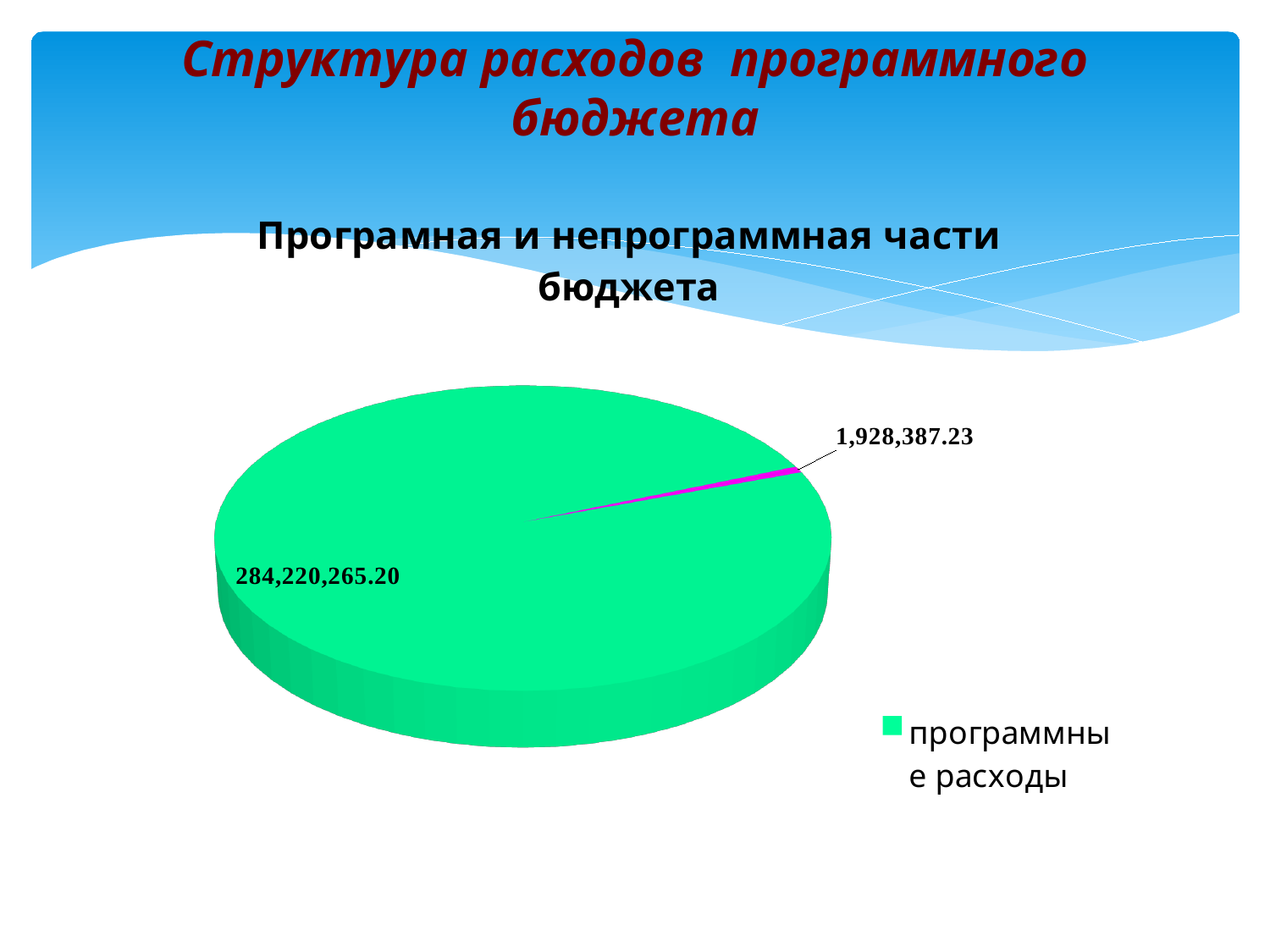
Which is larger: the green slice or the magenta slice? the green slice How many entries does the chart legend list? 1 How many slices does the pie chart have? 2 What is the value of the smallest slice in the pie chart? 1,928,387.23 What colour is the slice for программные расходы? green Which slice of the pie is the largest? программные расходы What is the title of the chart? Програмная и непрограммная части бюджета What is the value shown for программные расходы? 284,220,265.20 What is the difference between the two values shown on the pie chart? 282,291,877.97 What kind of chart is shown on the slide? pie chart What is the value shown for the small magenta slice of the pie? 1,928,387.23